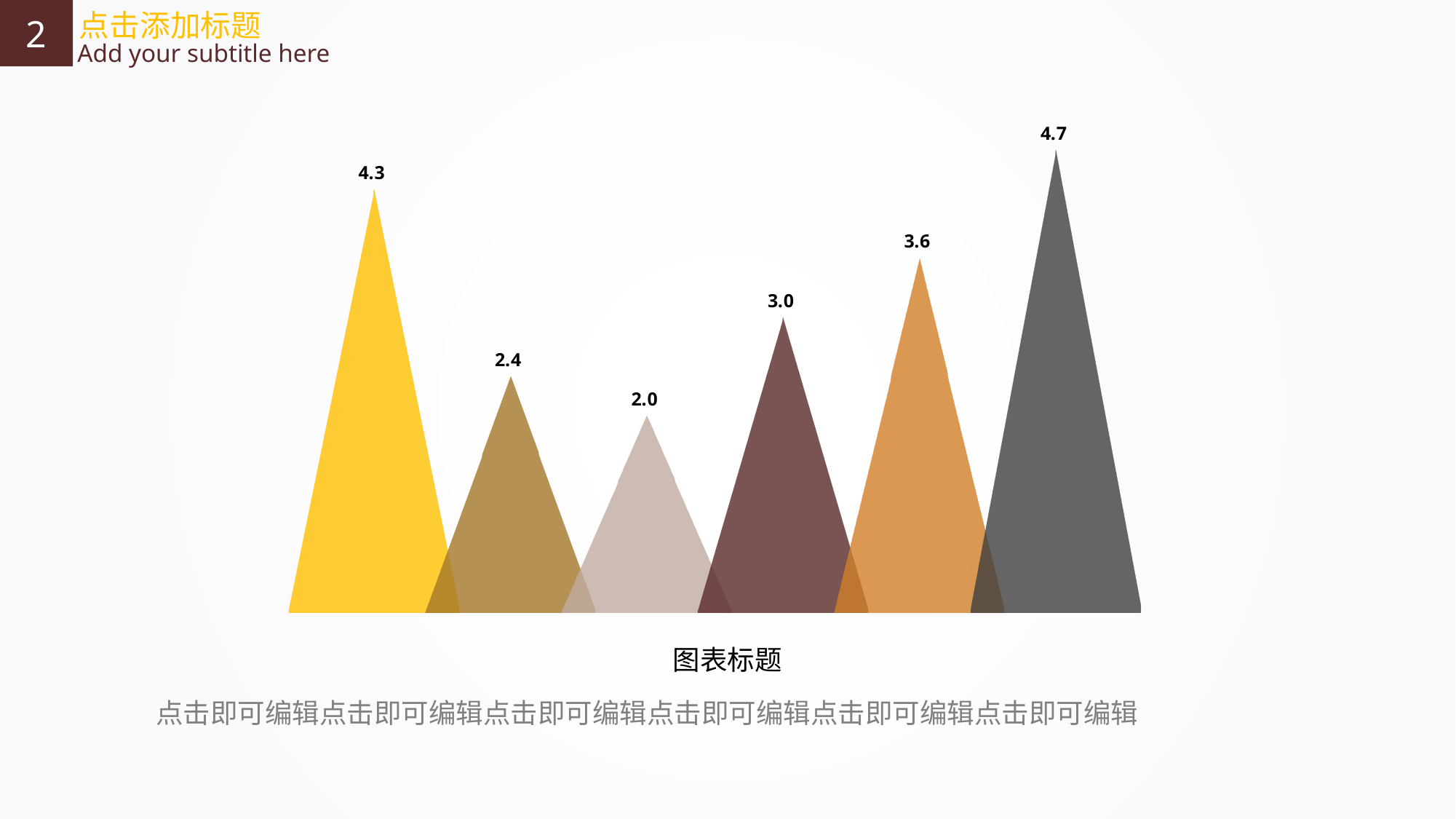
What is the value shown on the dark grey triangle at the far right? 4.7 Which is larger, the value of the first yellow triangle or the value of the orange triangle? The yellow triangle (4.3) Which triangle has the lowest value? The light beige one, third from the left (2.0) What is the difference between the orange triangle's value and the dark brown triangle's value? 0.6 What is the value shown on the third triangle from the left (the light beige one)? 2.0 Which triangle has the highest value? The dark grey one at the far right (4.7) How many triangles (data points) are plotted in the chart? 6 What is the title printed below the chart? 图表标题 What is the value shown on the dark brown triangle in the middle? 3.0 What is the difference between the highest value (4.7) and the lowest value (2.0)? 2.7 What is the value shown on the first (yellow) triangle from the left? 4.3 Do the values rise or fall from the third triangle to the sixth triangle? Rise